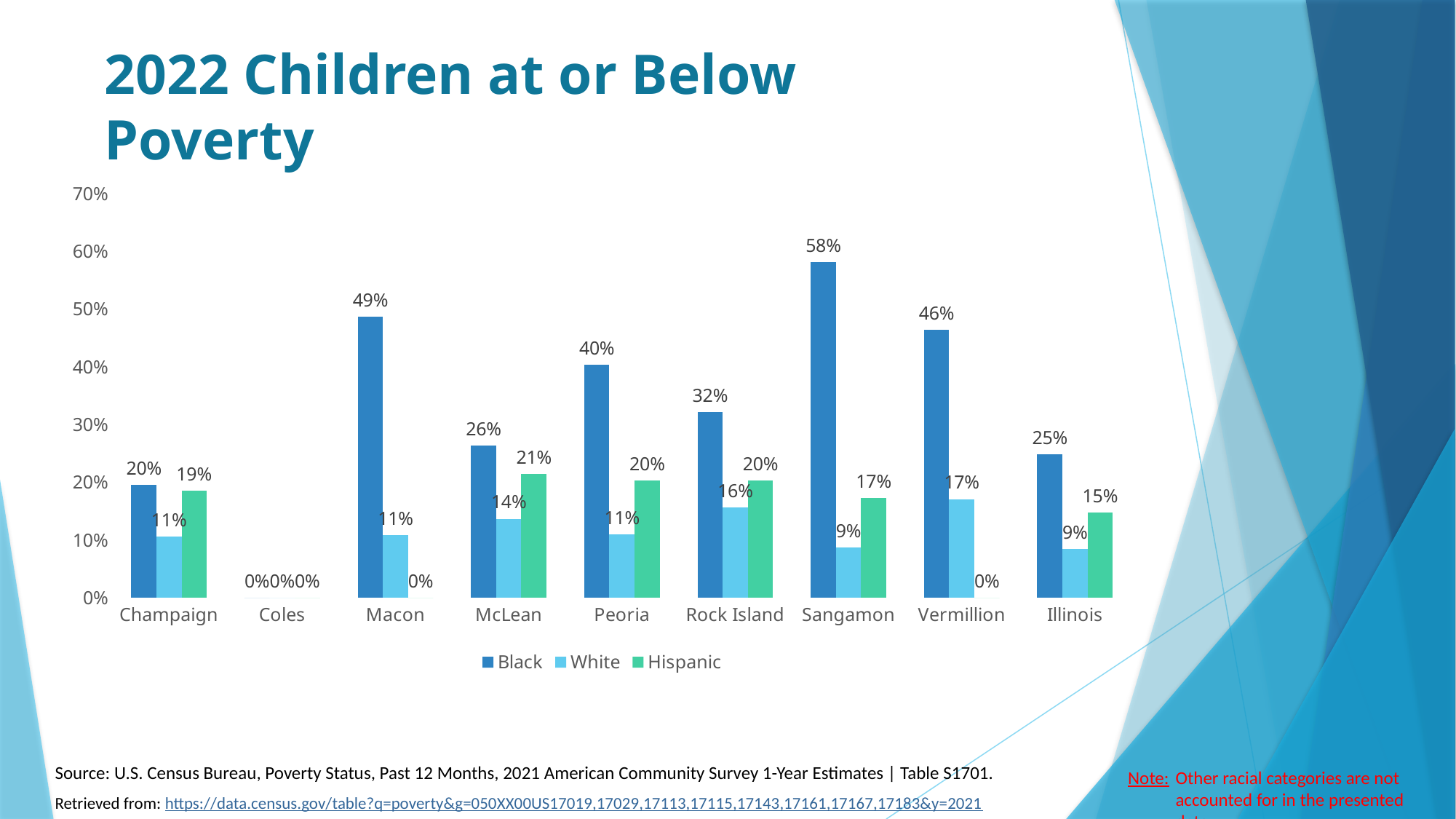
How many categories are shown on the x axis? 9 Which category has the highest value for the Black series? Sangamon What is the value for Hispanic in McLean? 21% How many series does the legend list? 3 What is the value for Black in Sangamon? 58% What kind of chart is shown on the slide? bar chart What is the value for White in Vermillion? 17% Which category has the lowest value for the Hispanic series, excluding the 0% values? Illinois What is the title of the slide? 2022 Children at or Below Poverty Is the Black value for Vermillion greater or less than 40%? greater What is the difference between the Black and White values for Macon? 38% Which is larger, the Black value for Peoria or the Black value for Rock Island? Peoria